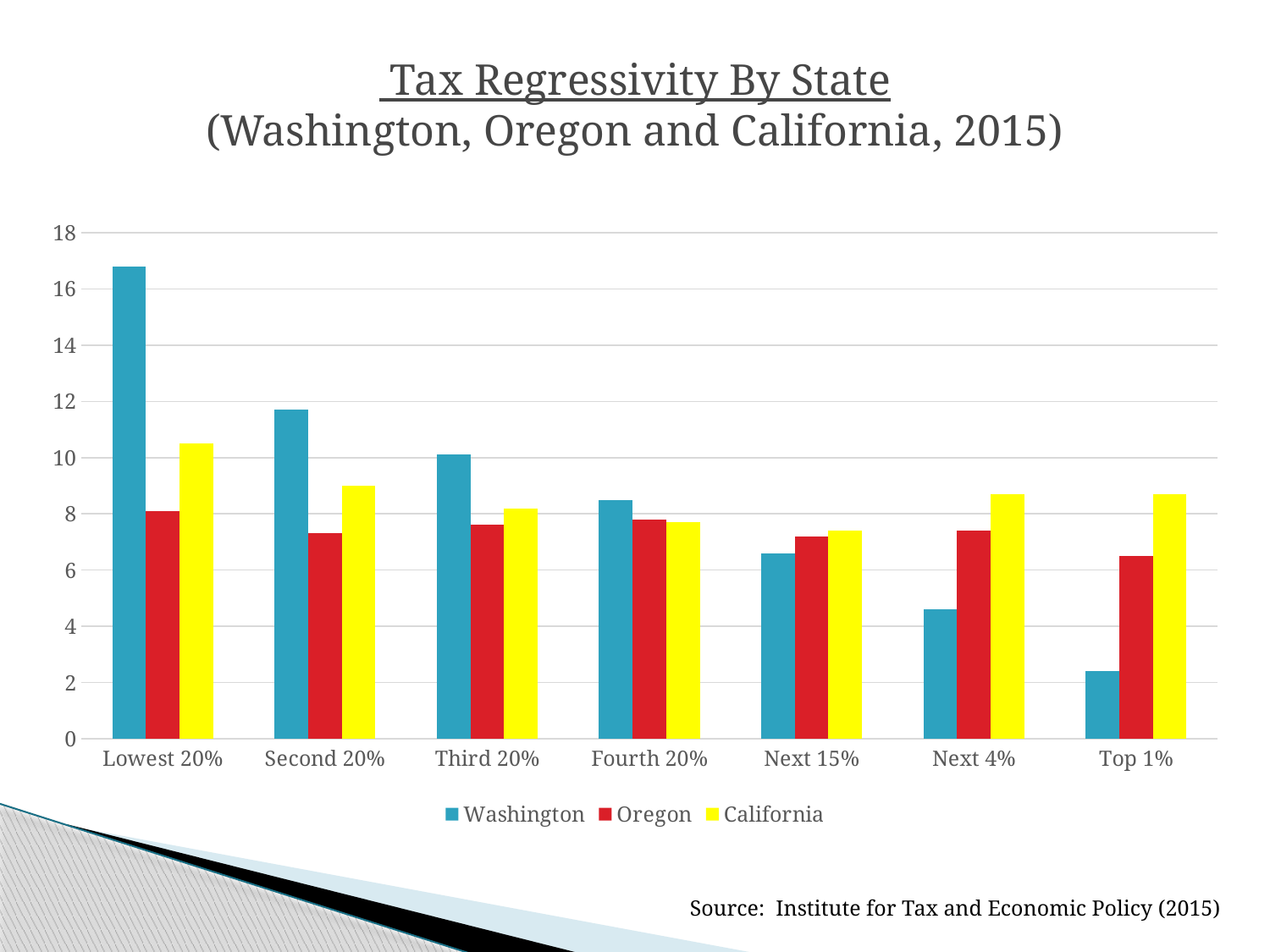
For which income group is the Washington value highest? Lowest 20% Is the Washington value for Lowest 20% greater or less than 14? greater How many series does the legend list? 3 Which states are listed in the chart legend? Washington, Oregon, California Do the Washington values rise or fall moving from Lowest 20% to Top 1%? fall Is the Oregon value for Lowest 20% greater or less than 10? less For the Lowest 20% group, which is larger: Washington or California? Washington Is the Washington value for Top 1% greater or less than 4? less How many income groups are shown along the x axis? 7 For the Top 1% group, which is larger: California or Washington? California What kind of chart is shown on the slide? bar chart For which income group is the Washington value lowest? Top 1%